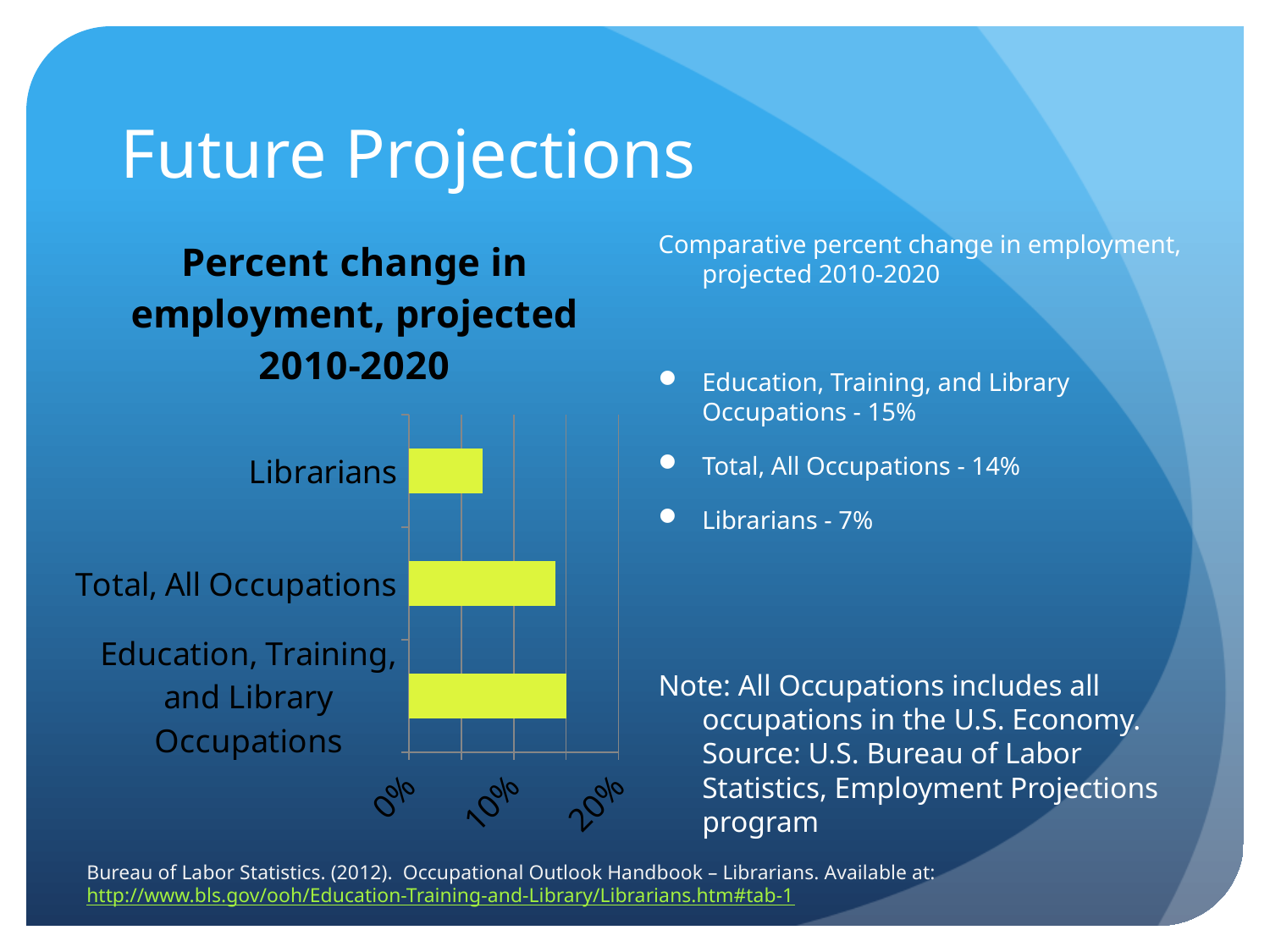
Which is larger, the value for Total, All Occupations or the value for Librarians? Total, All Occupations Which category has the highest projected percent change in employment? Education, Training, and Library Occupations How many categories does the chart show? 3 Which category has the lowest projected percent change in employment? Librarians What is the projected percent change in employment for Education, Training, and Library Occupations? 15% What is the difference between the projected percent change for Total, All Occupations and for Librarians? 7% What is the projected percent change in employment for Librarians? 7% What kind of chart is shown on the slide? bar chart What is the title of the chart? Percent change in employment, projected 2010-2020 Is the value for Education, Training, and Library Occupations greater or less than 10%? greater Is the value for Librarians greater or less than 10%? less What is the projected percent change in employment for Total, All Occupations? 14%